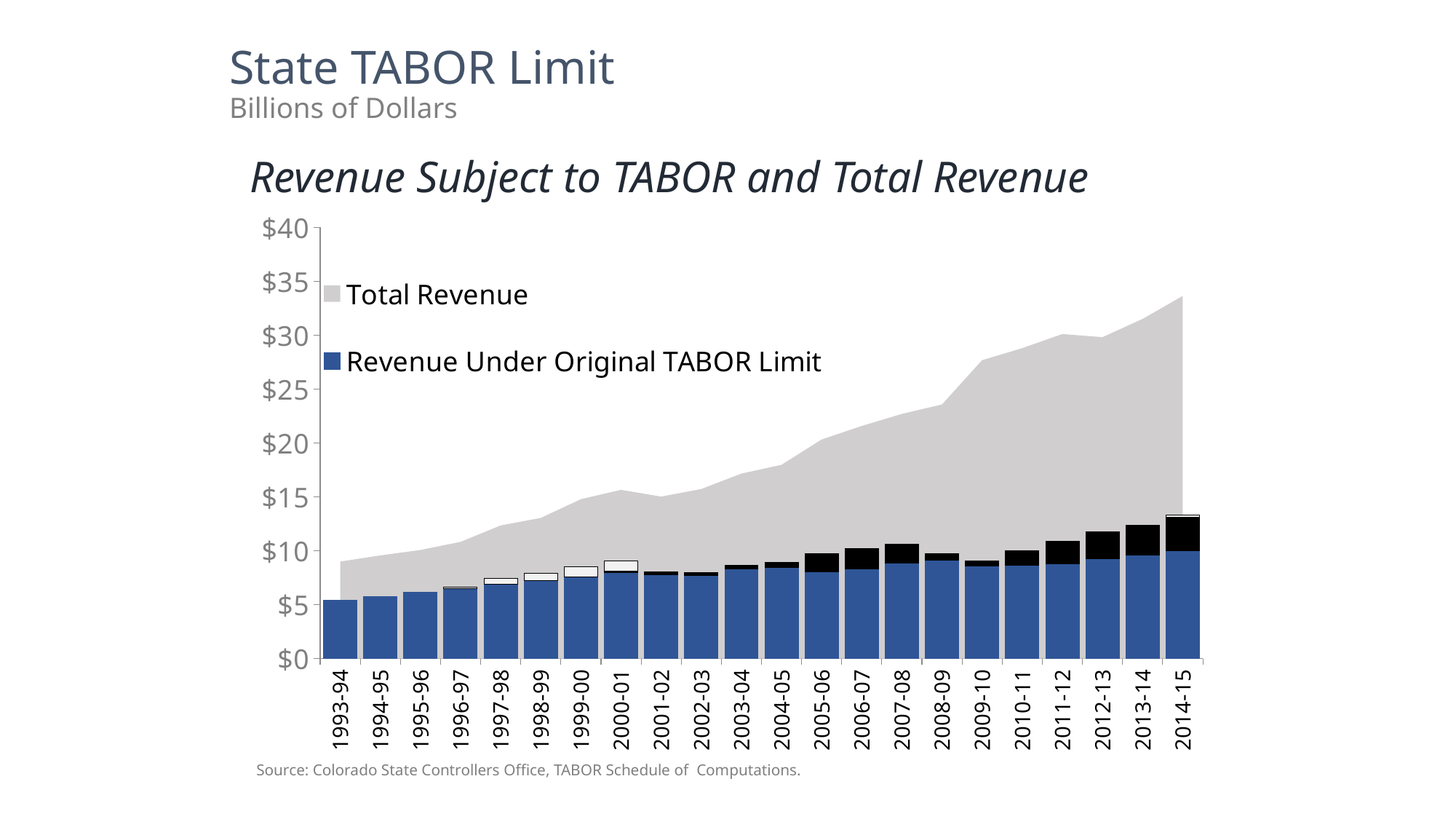
Which fiscal year has the highest Revenue Under Original TABOR Limit? 2014-15 How many fiscal years are shown on the x axis? 22 Is Total Revenue for 2007-08 greater or less than $25? less What is the title of the chart? Revenue Subject to TABOR and Total Revenue Does Total Revenue generally rise or fall from 1993-94 to 2014-15? rise How many series does the legend list? 2 Is Total Revenue for 2014-15 greater or less than $30? greater Is Total Revenue for 1993-94 greater or less than $10? less What colour represents Total Revenue in the chart? Grey Which is larger, Revenue Under Original TABOR Limit in 2013-14 or in 1993-94? 2013-14 Which fiscal year has the lowest Revenue Under Original TABOR Limit? 1993-94